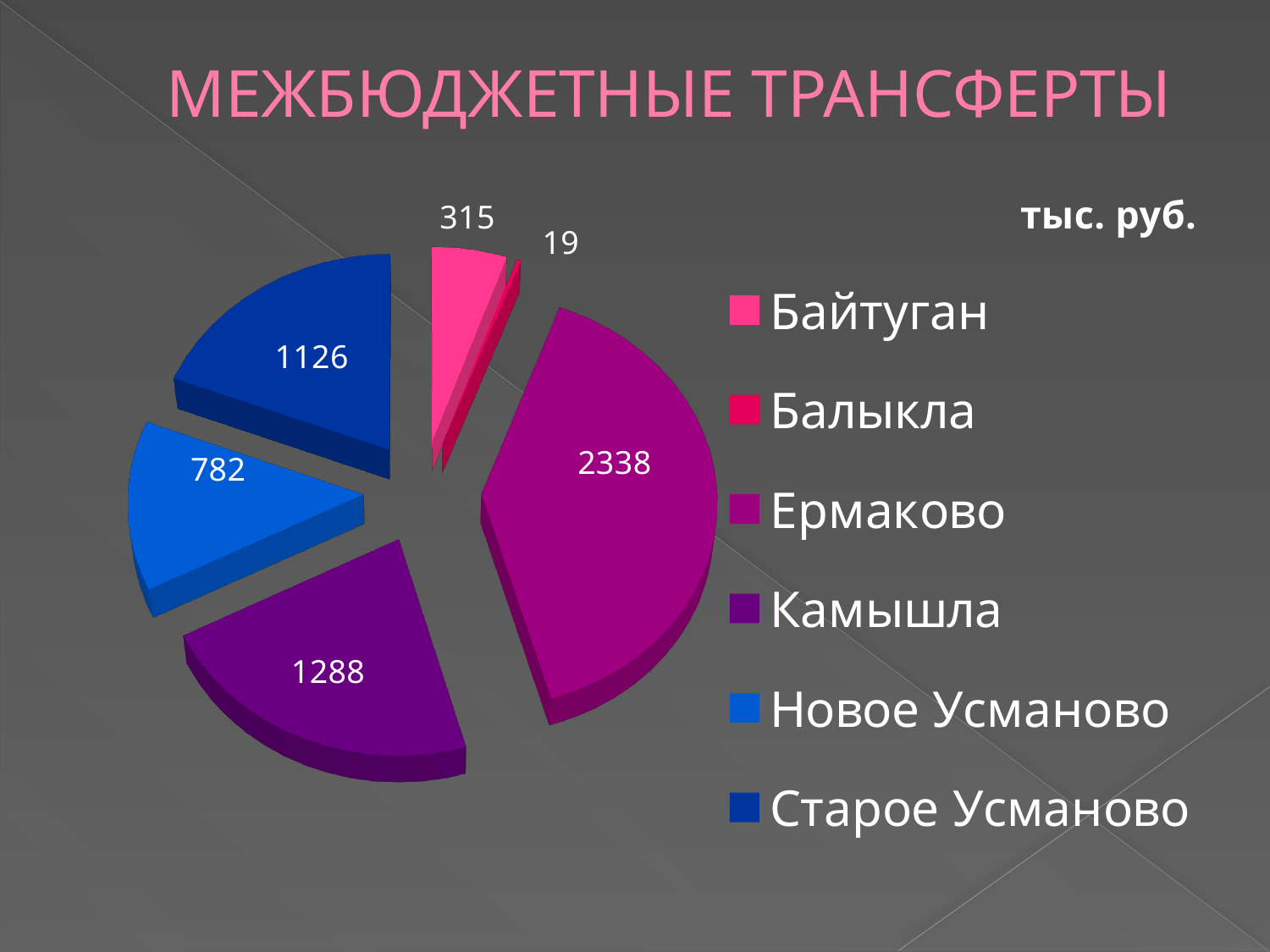
How many categories does the pie chart have? 6 What unit is indicated for the values on the slide? тыс. руб. What is the value for Ермаково? 2338 What is the value for Старое Усманово? 1126 Which category has the smallest slice? Балыкла What kind of chart is shown on the slide? pie chart Which is larger, the value for Камышла or the value for Старое Усманово? Камышла Which category has the largest slice? Ермаково What is the value for Балыкла? 19 What is the difference between the values for Старое Усманово and Новое Усманово? 344 What is the difference between the values for Ермаково and Камышла? 1050 What is the value for Новое Усманово? 782